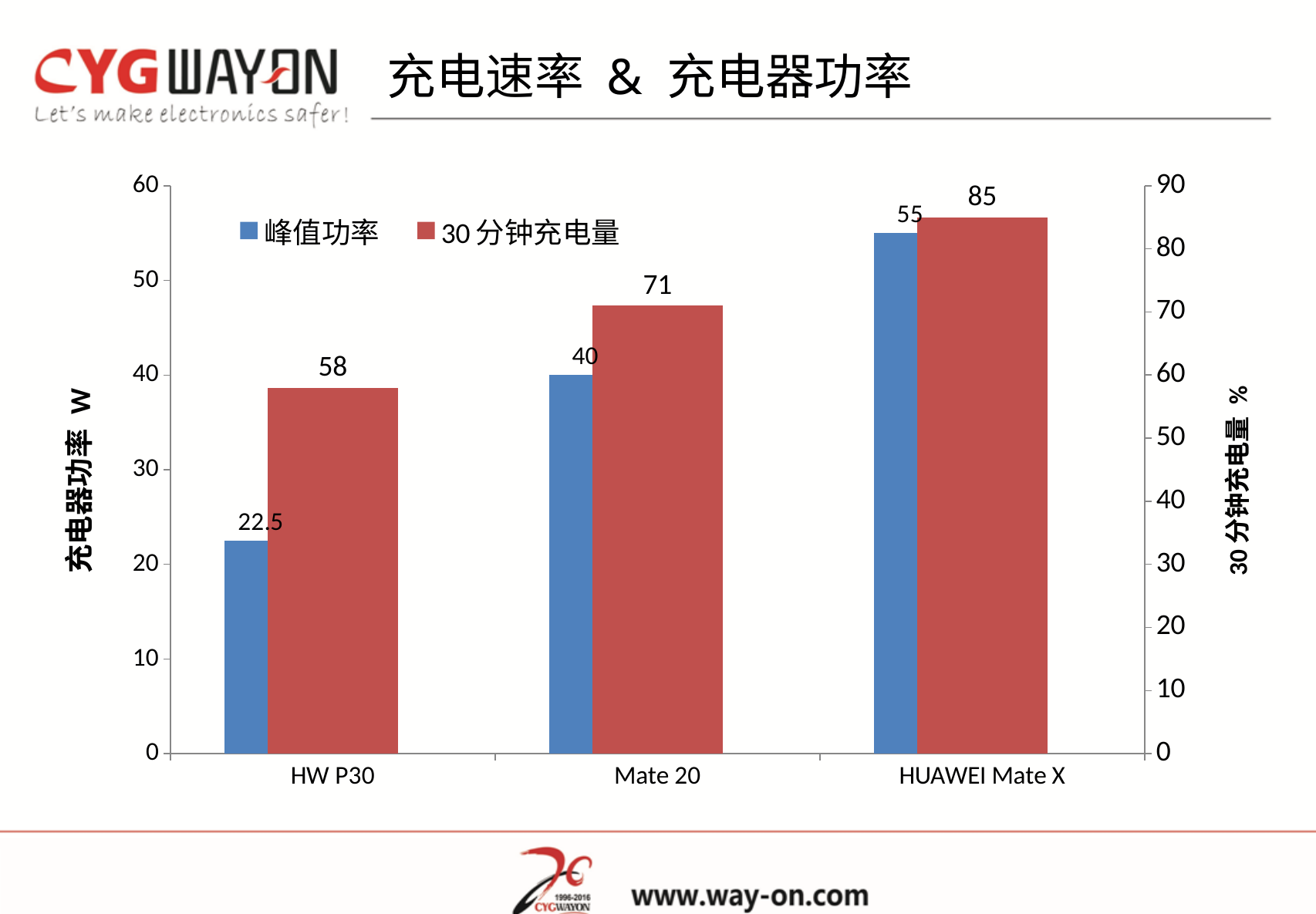
What is the difference in 峰值功率 between HUAWEI Mate X and Mate 20? 15 What is the 峰值功率 value for HW P30? 22.5 What is the 峰值功率 value for HUAWEI Mate X? 55 What kind of chart is shown on the slide? Bar chart Which category has the lowest 30 分钟充电量? HW P30 What is the 30 分钟充电量 value for HW P30? 58 How many categories are shown on the x axis? 3 What is the difference in 30 分钟充电量 between HUAWEI Mate X and HW P30? 27 Which has a larger 峰值功率, HW P30 or Mate 20? Mate 20 What is the 30 分钟充电量 value for Mate 20? 71 Which category has the highest 峰值功率? HUAWEI Mate X How many series does the legend list? 2